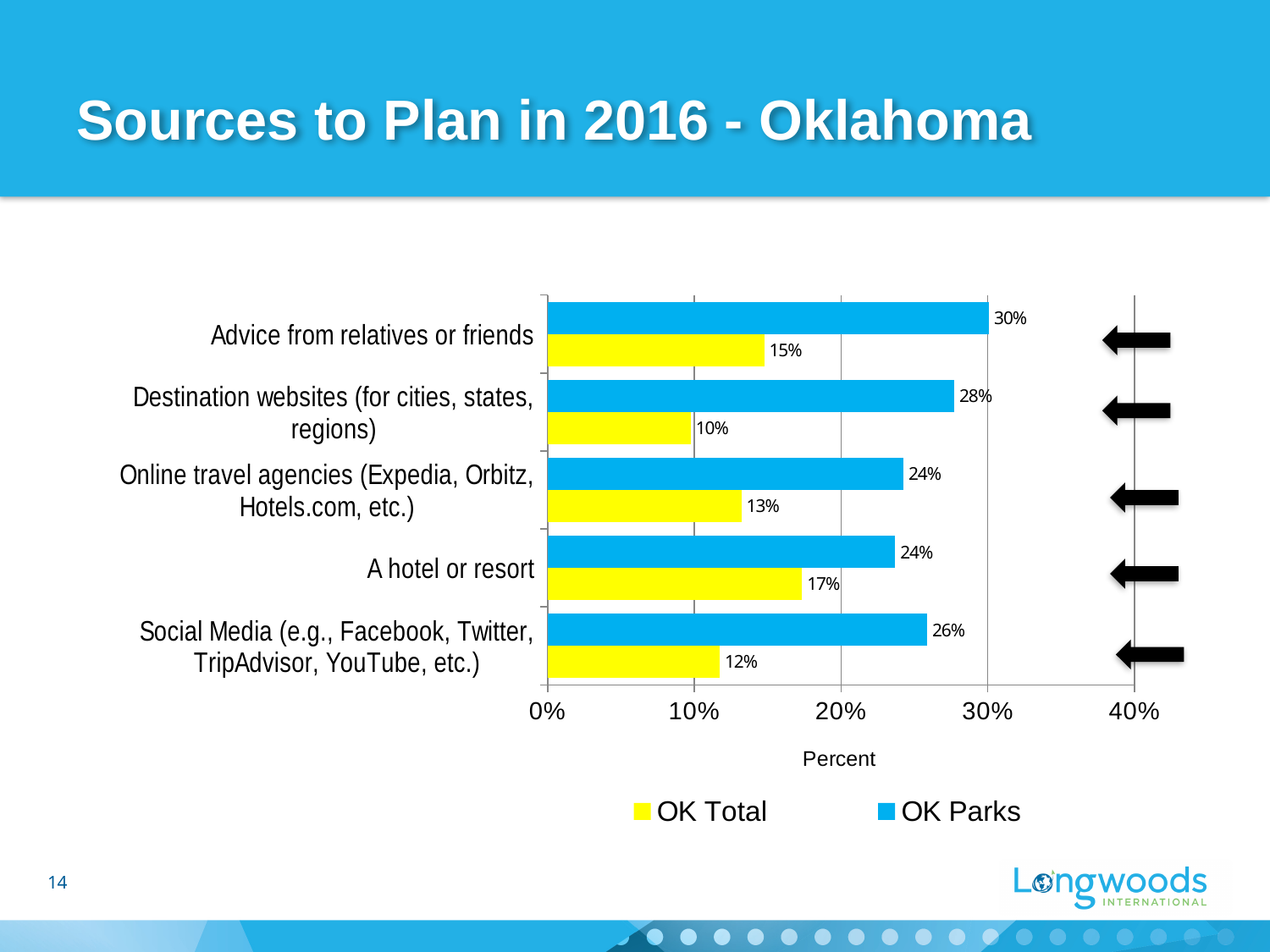
What is the OK Parks value for Advice from relatives or friends? 30% What is the OK Total value for A hotel or resort? 17% What is the OK Total value for Destination websites (for cities, states, regions)? 10% Which is larger for Online travel agencies (Expedia, Orbitz, Hotels.com, etc.): the OK Parks value or the OK Total value? OK Parks Which colour represents the OK Total series? Yellow What is the OK Parks value for Social Media (e.g., Facebook, Twitter, TripAdvisor, YouTube, etc.)? 26% What is the difference between the OK Parks and OK Total values for Advice from relatives or friends? 15% Which category has the lowest OK Total value? Destination websites (for cities, states, regions) What kind of chart is shown on the slide? Bar chart How many categories are shown on the chart? 5 How many series does the legend list? 2 Which category has the highest OK Parks value? Advice from relatives or friends